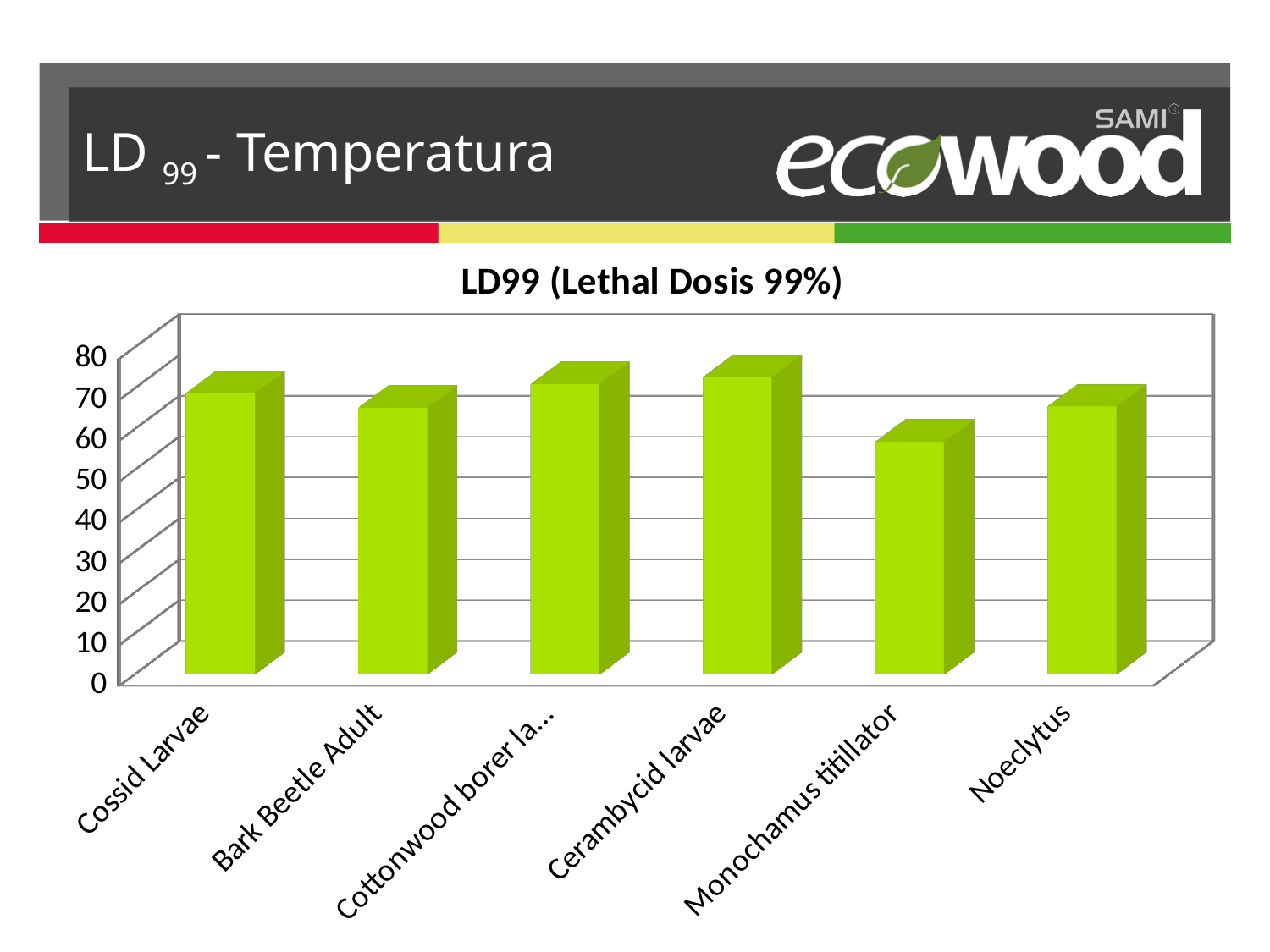
Which category has the highest value in the chart? Cerambycid larvae Which category has the lowest value in the chart? Monochamus titillator Which is larger, the value for Cerambycid larvae or the value for Monochamus titillator? Cerambycid larvae What type of chart is shown on the slide? bar chart Is the value for Bark Beetle Adult greater or less than 70? less Is the value for Cerambycid larvae greater or less than 70? greater Is the value for Monochamus titillator greater or less than 70? less Which is larger, the value for Cossid Larvae or the value for Bark Beetle Adult? Cossid Larvae How many categories are shown on the x axis of the chart? 6 What is the title of the chart? LD99 (Lethal Dosis 99%) What colour are the bars in the chart? green